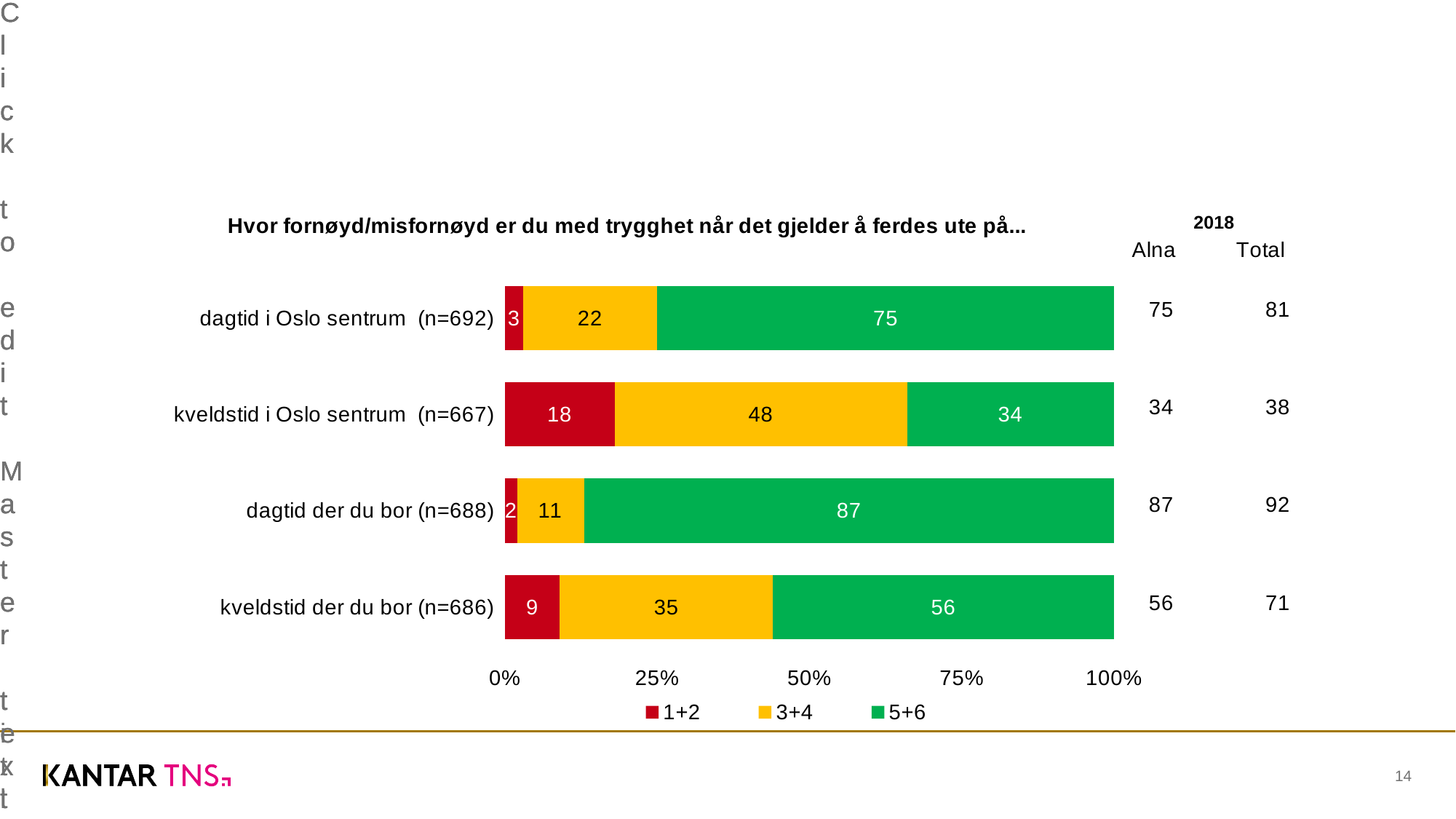
Which colour represents the 1+2 series in the legend? Red What is the value of the 5+6 series for 'dagtid i Oslo sentrum (n=692)'? 75 What is the difference between the 5+6 values for 'dagtid der du bor (n=688)' and 'kveldstid der du bor (n=686)'? 31 What is the value of the 3+4 series for 'kveldstid der du bor (n=686)'? 35 How many series does the legend list? 3 How many categories are shown on the chart? 4 What kind of chart is shown on the slide? Stacked bar chart Which category has the lowest value for the 5+6 series? kveldstid i Oslo sentrum (n=667) What is the value of the 1+2 series for 'kveldstid i Oslo sentrum (n=667)'? 18 Which category has the highest value for the 5+6 series? dagtid der du bor (n=688) Which is larger: the 3+4 value for 'kveldstid i Oslo sentrum (n=667)' or the 3+4 value for 'kveldstid der du bor (n=686)'? kveldstid i Oslo sentrum (n=667) What is the total of the stacked bar for 'dagtid der du bor (n=688)'? 100